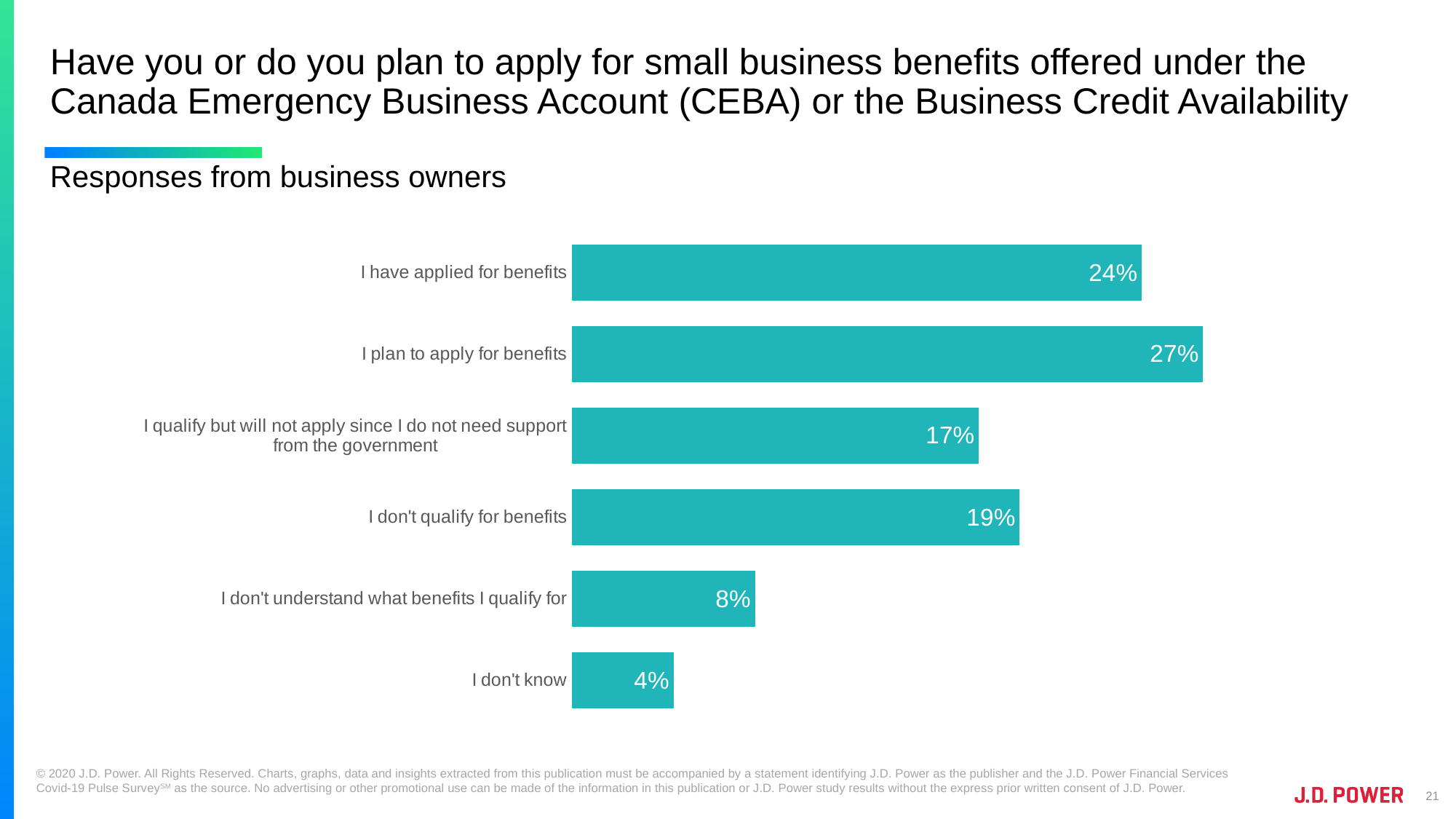
What percentage of business owners said "I don't know"? 4% What is the difference in percentage points between "I plan to apply for benefits" and "I have applied for benefits"? 3 percentage points What is the subtitle shown above the chart? Responses from business owners What percentage of business owners said "I plan to apply for benefits"? 27% Which response has the lowest percentage? I don't know Which is larger: the percentage for "I don't qualify for benefits" or for "I qualify but will not apply since I do not need support from the government"? I don't qualify for benefits What percentage of business owners said "I don't understand what benefits I qualify for"? 8% What percentage of business owners said "I have applied for benefits"? 24% What type of chart is shown on the slide? Bar chart What percentage of business owners said "I don't qualify for benefits"? 19% How many response categories are shown in the chart? 6 Which response has the highest percentage? I plan to apply for benefits